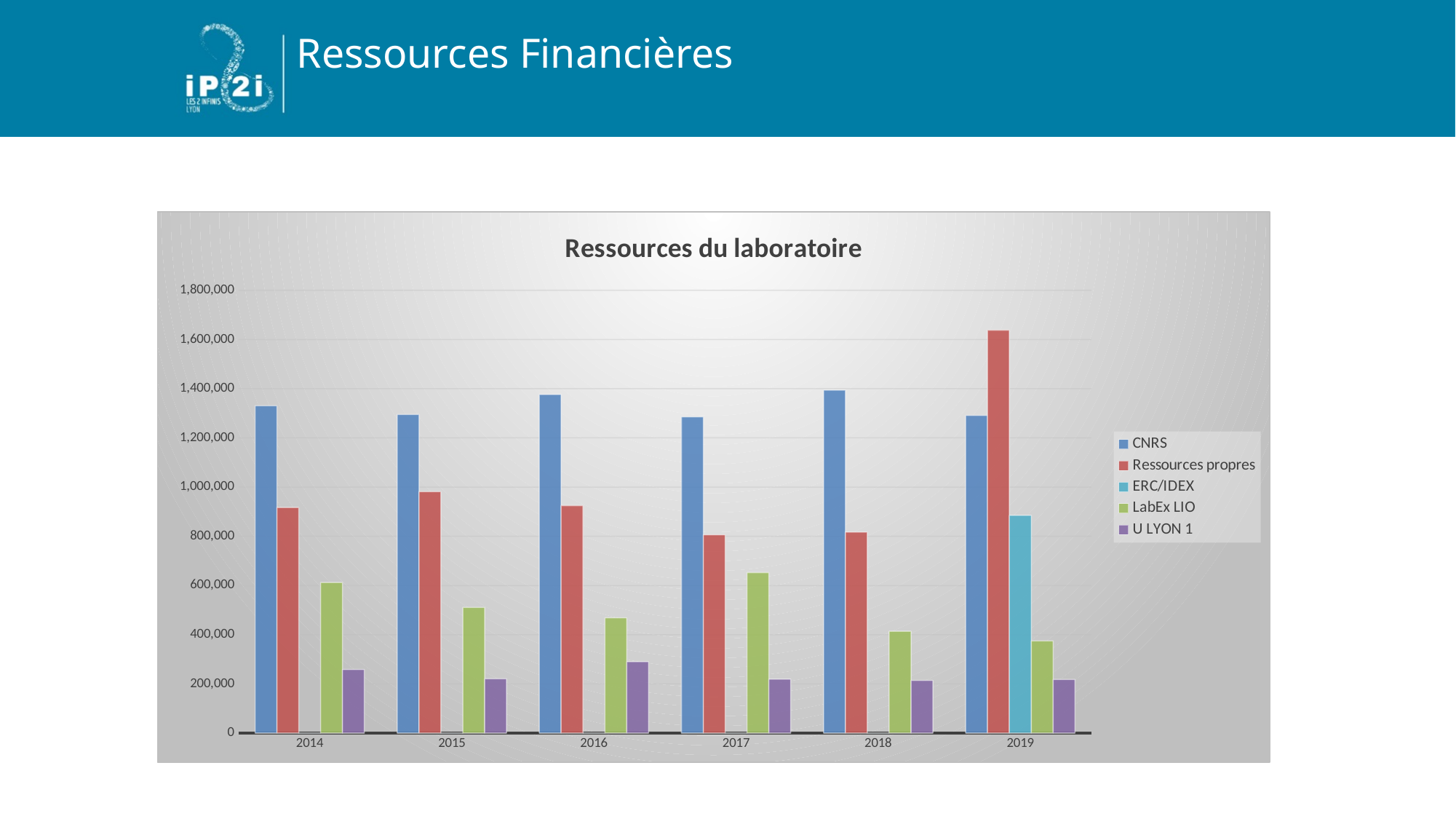
How many years are shown on the x axis of the chart? 6 In which year is the Ressources propres bar the highest? 2019 In which year does the ERC/IDEX series appear in the chart? 2019 How many series does the legend of the chart list? 5 In 2019, which is larger: the CNRS bar or the Ressources propres bar? Ressources propres What is the title of the chart? Ressources du laboratoire What kind of chart is shown on the slide? Bar chart Is the value for Ressources propres in 2019 greater or less than 1,600,000? greater Is the value for CNRS in 2014 greater or less than 1,200,000? greater Which is larger: the CNRS value in 2018 or the CNRS value in 2017? 2018 Is the value for U LYON 1 in 2016 greater or less than 200,000? greater